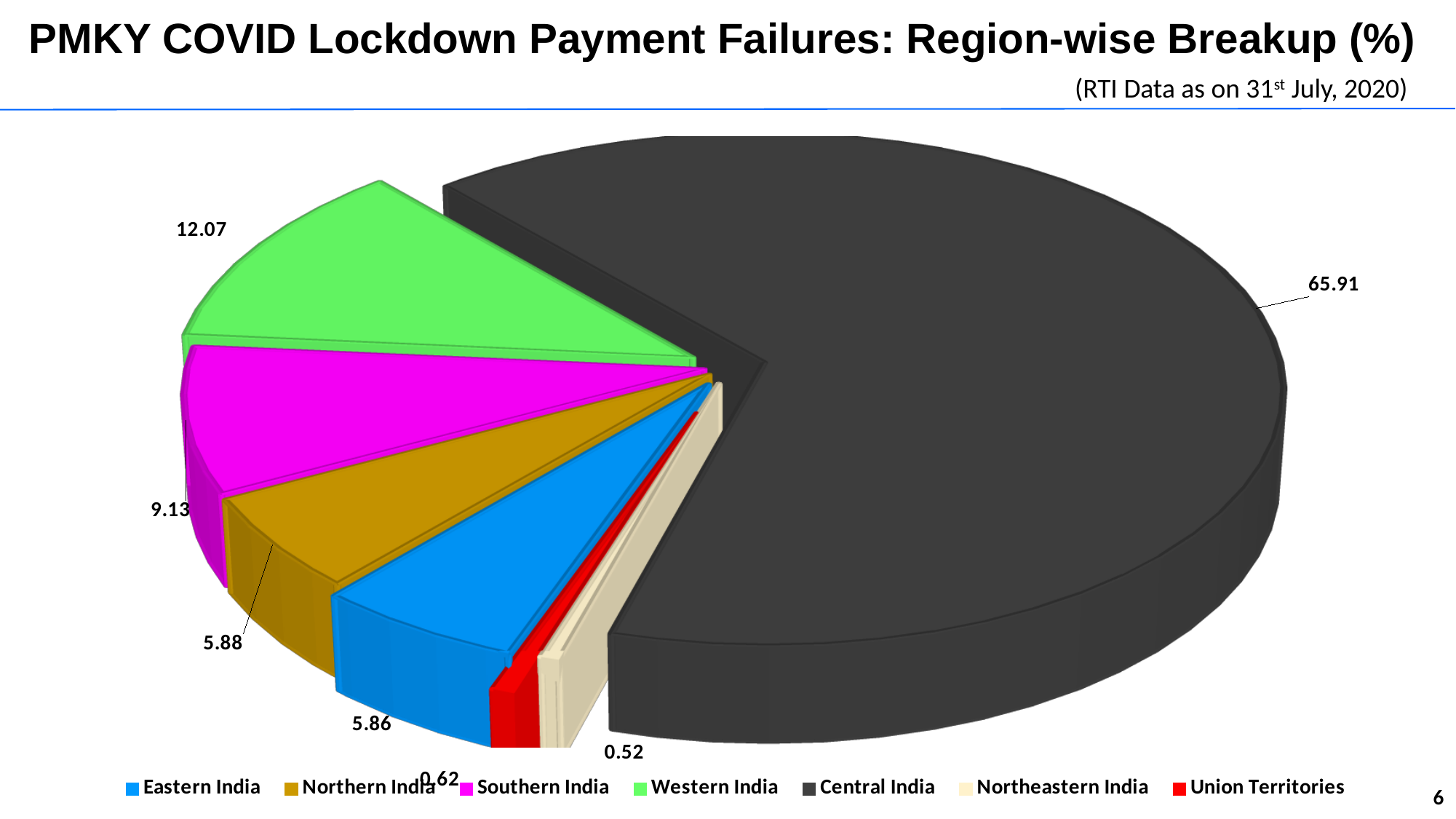
Which region has the largest share of payment failures? Central India What is the value for Southern India? 9.13 What kind of chart is shown on the slide? pie chart What is the value for Western India? 12.07 What is the title of the chart? PMKY COVID Lockdown Payment Failures: Region-wise Breakup (%) Which is larger, the value for Western India or the value for Southern India? Western India What is the value for Eastern India? 5.86 What is the difference between the values for Western India and Southern India? 2.94 What is the smallest value shown on the pie chart? 0.52 What is the value for Northern India? 5.88 How many regions (slices) does the pie chart show? 7 What is the value for Central India? 65.91